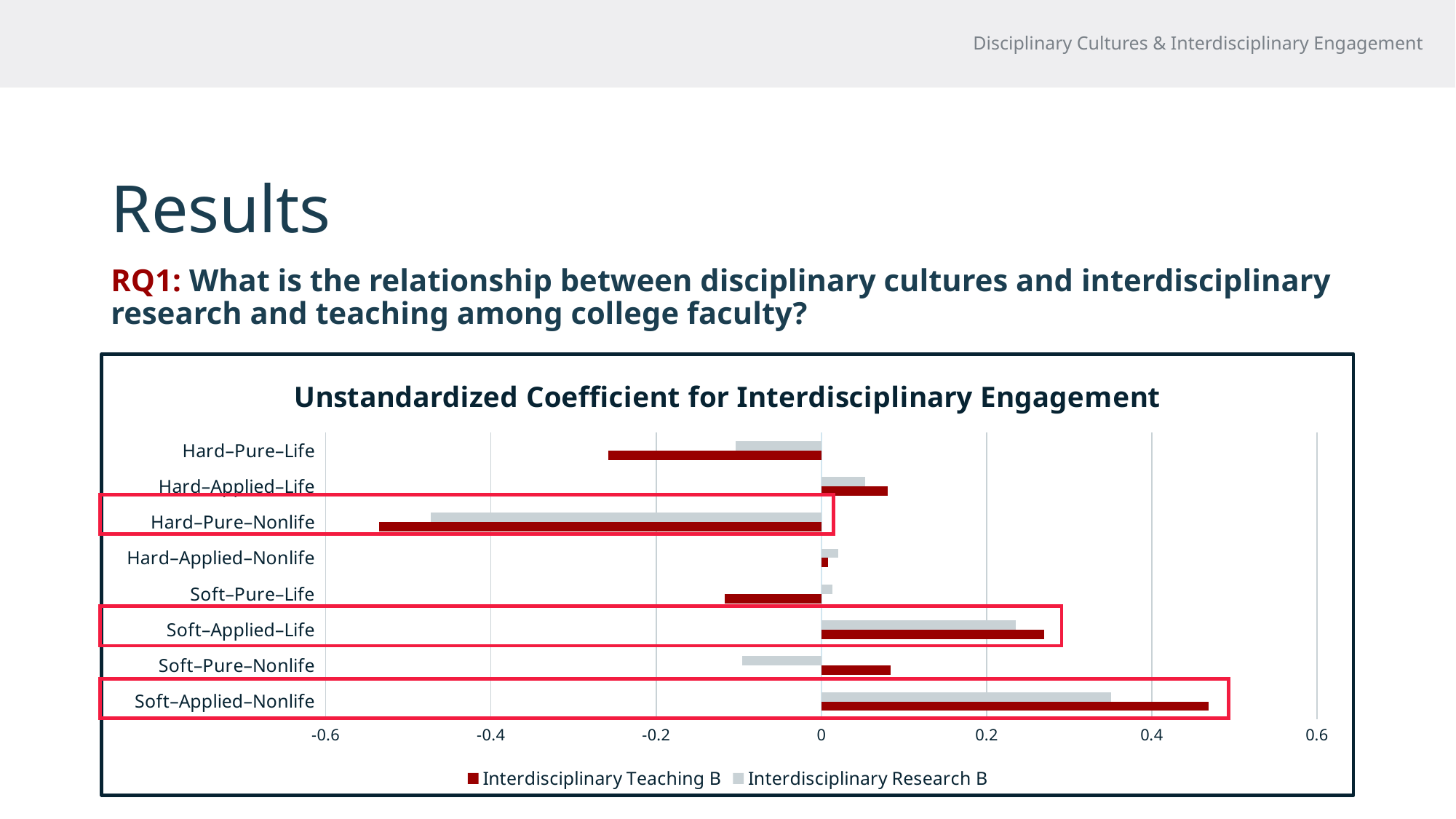
What is the title of the chart? Unstandardized Coefficient for Interdisciplinary Engagement Is the Interdisciplinary Teaching B value for Soft–Applied–Nonlife greater or less than 0.4? greater Which category has the lowest Interdisciplinary Teaching B value? Hard–Pure–Nonlife How many disciplinary categories are plotted on the chart? 8 Which category has the highest Interdisciplinary Teaching B value? Soft–Applied–Nonlife Which category has the lowest Interdisciplinary Research B value? Hard–Pure–Nonlife Is the Interdisciplinary Research B value for Soft–Applied–Life greater or less than 0.2? greater Which category has the highest Interdisciplinary Research B value? Soft–Applied–Nonlife How many series does the chart legend list? 2 For Soft–Pure–Nonlife, which series has the larger value: Interdisciplinary Teaching B or Interdisciplinary Research B? Interdisciplinary Teaching B What kind of chart is shown on the slide? Bar chart Is the Interdisciplinary Teaching B value for Hard–Pure–Nonlife greater or less than -0.4? less